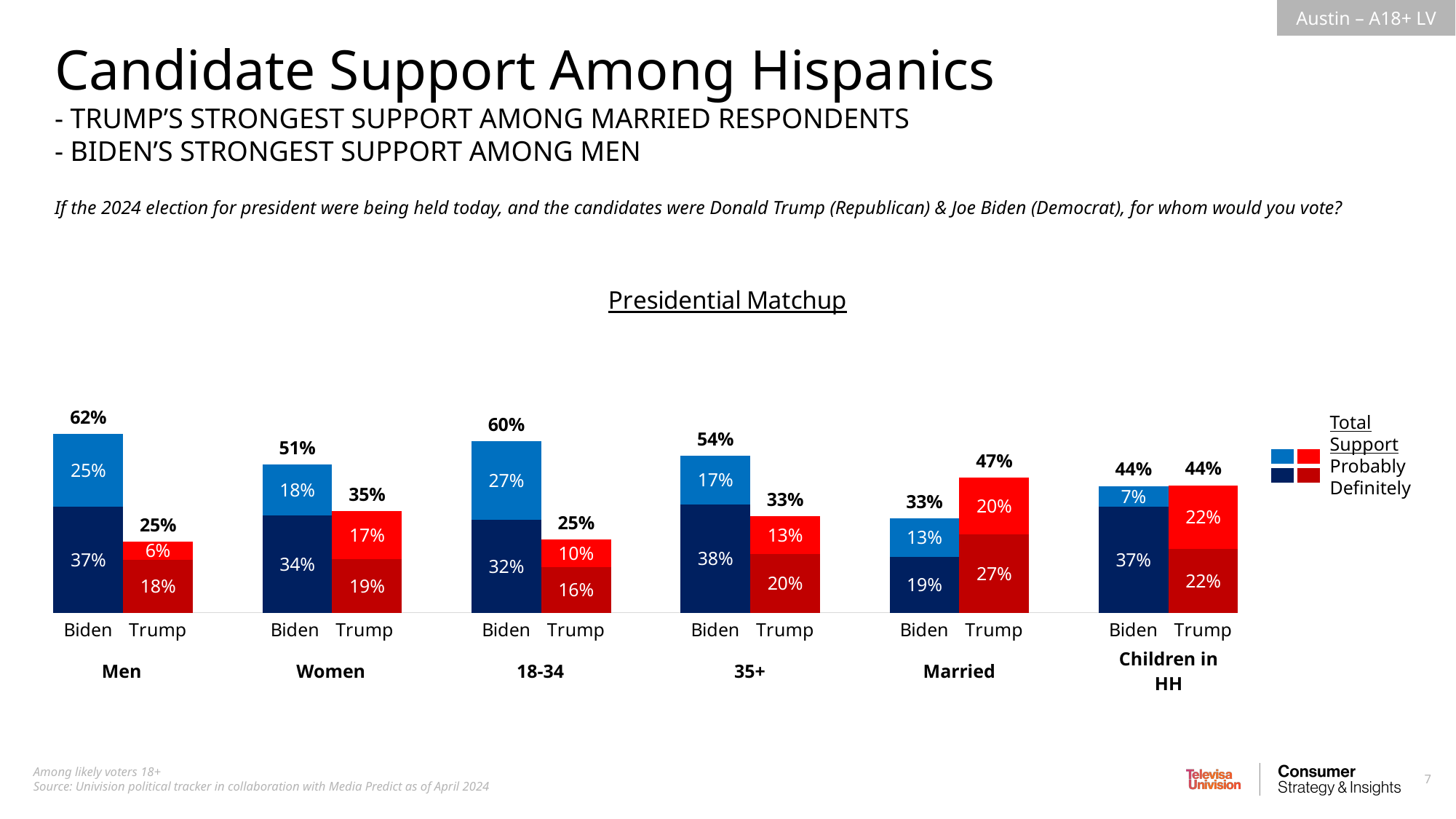
What is the title of the chart? Presidential Matchup What is Biden's total support among Men? 62% What is Trump's total support among Married respondents? 47% In which demographic group is Biden's total support highest? Men What is the 'Probably' value for Biden in the Children in HH group? 7% How many demographic groups are shown on the chart? 6 What is the 'Definitely' value for Trump among Women? 19% What kind of chart is shown on the slide? Stacked bar chart What is the difference between Biden's and Trump's total support among Men? 37% What is the total of the Trump bar for the 35+ group? 33% In which demographic group is Trump's total support lowest? Men and 18-34 (tied at 25%) Who has higher total support among Married respondents, Biden or Trump? Trump